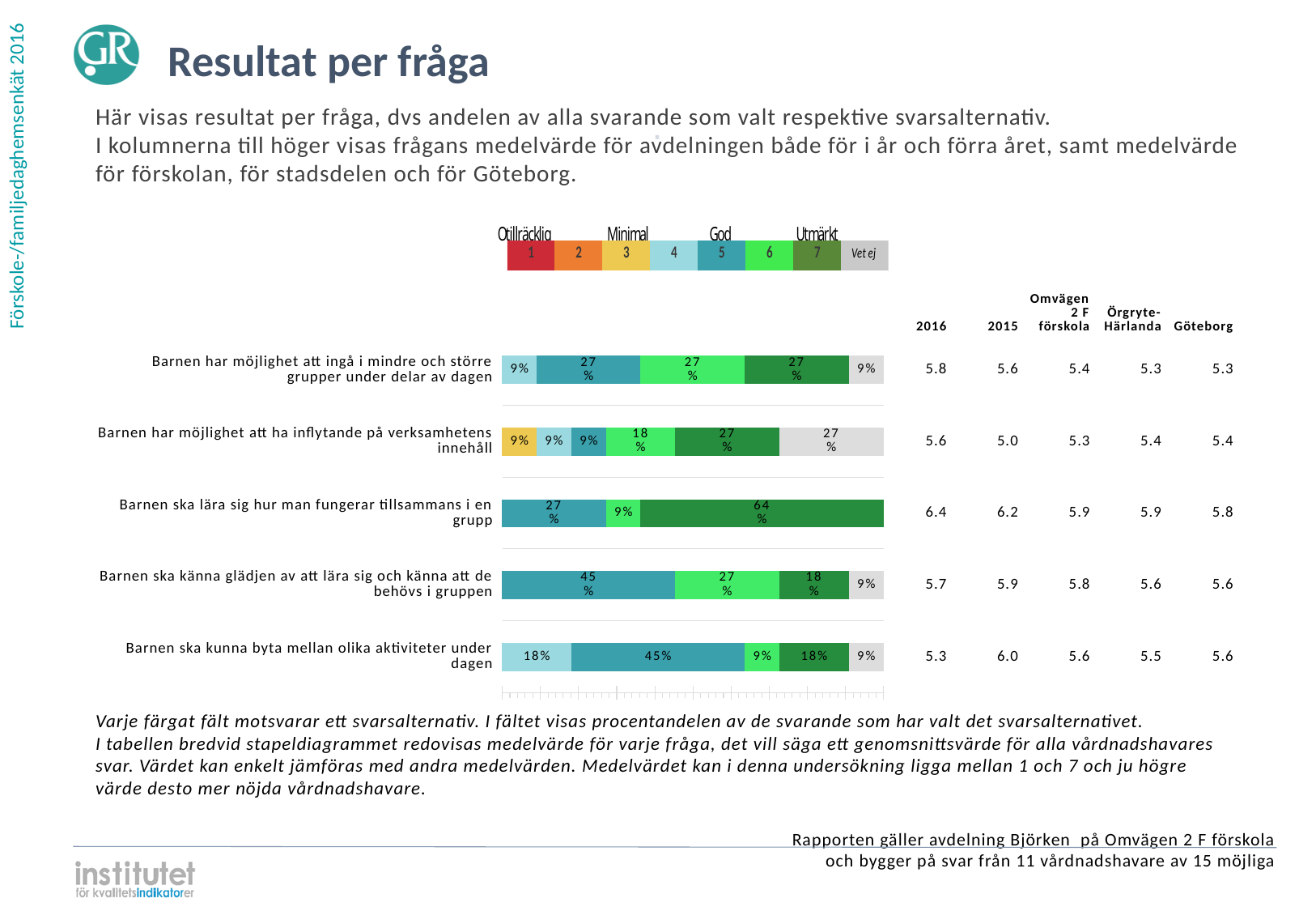
For "Barnen ska kunna byta mellan olika aktiviteter under dagen", which is larger: the share for answer 4 or the share for answer 5? Answer 5 (45%) What is the 2016 mean value for "Barnen ska lära sig hur man fungerar tillsammans i en grupp"? 6.4 What percentage chose answer 5 for "Barnen ska känna glädjen av att lära sig och känna att de behövs i gruppen"? 45% What is the difference between the answer-7 share for "Barnen ska lära sig hur man fungerar tillsammans i en grupp" (64%) and for "Barnen ska kunna byta mellan olika aktiviteter under dagen" (18%)? 46 percentage points What is the "Vet ej" share for "Barnen har möjlighet att ha inflytande på verksamhetens innehåll"? 27% Which answer alternatives does the legend group under the label "Utmärkt"? 7 What is the Göteborg mean value for "Barnen har möjlighet att ha inflytande på verksamhetens innehåll"? 5.4 Which question has the lowest 2016 mean value? Barnen ska kunna byta mellan olika aktiviteter under dagen How many questions (bars) are shown in the chart? 5 What kind of chart is used to show the share of respondents per answer alternative? Stacked bar chart Which question has the largest share of respondents choosing answer 7? Barnen ska lära sig hur man fungerar tillsammans i en grupp What percentage of respondents chose answer 7 (dark green) for "Barnen ska lära sig hur man fungerar tillsammans i en grupp"? 64%